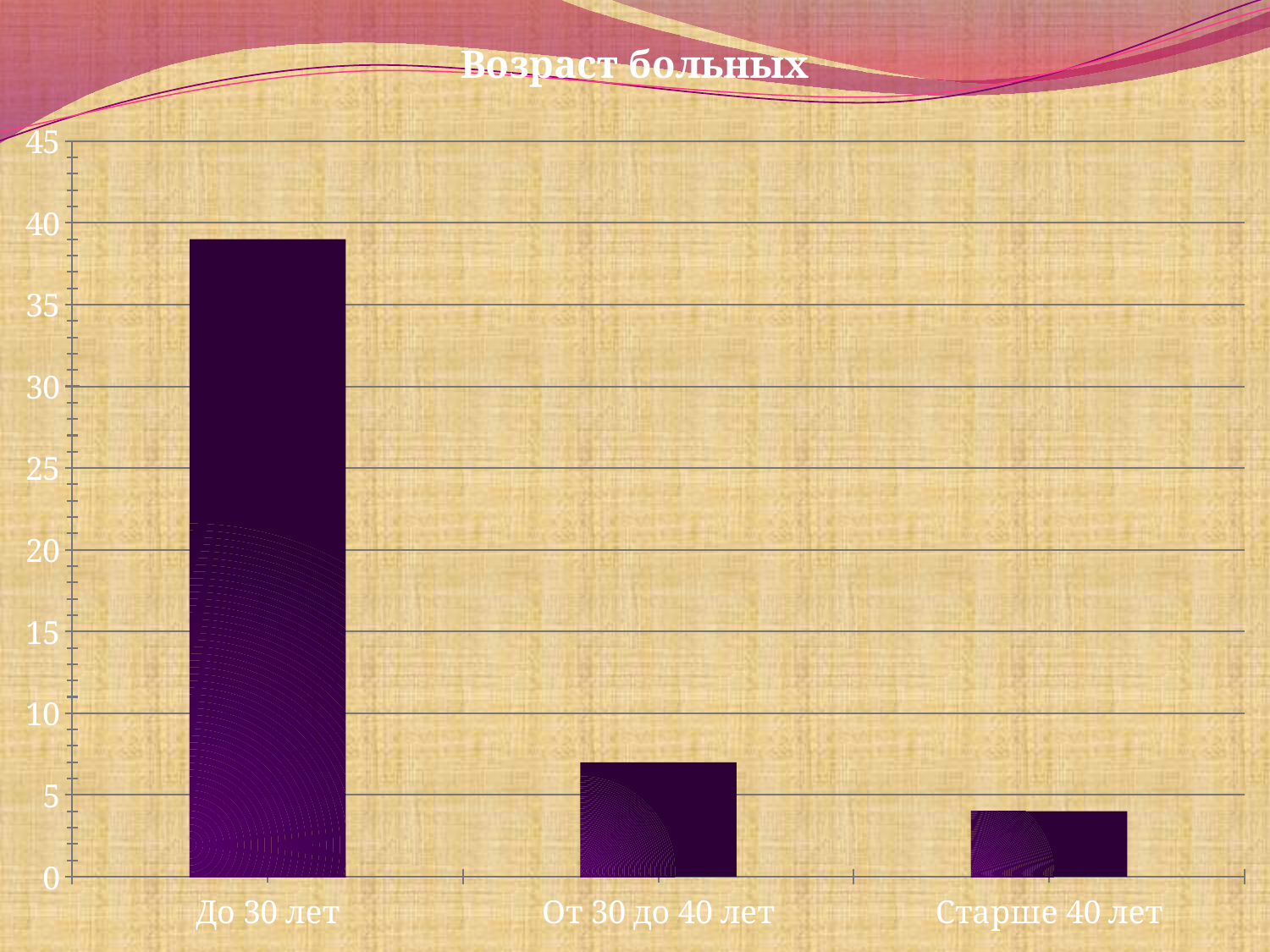
How many categories are shown on the x axis? 3 Do the values rise or fall from left to right along the x axis? fall Is the value for От 30 до 40 лет greater or less than 5? greater Which is larger, the value for От 30 до 40 лет or the value for Старше 40 лет? От 30 до 40 лет Is the value for Старше 40 лет greater or less than 5? less Is the value for До 30 лет greater or less than 40? less Which category has the lowest value? Старше 40 лет What is the title of the chart? Возраст больных What type of chart is shown on the slide? bar chart Which category has the highest value? До 30 лет